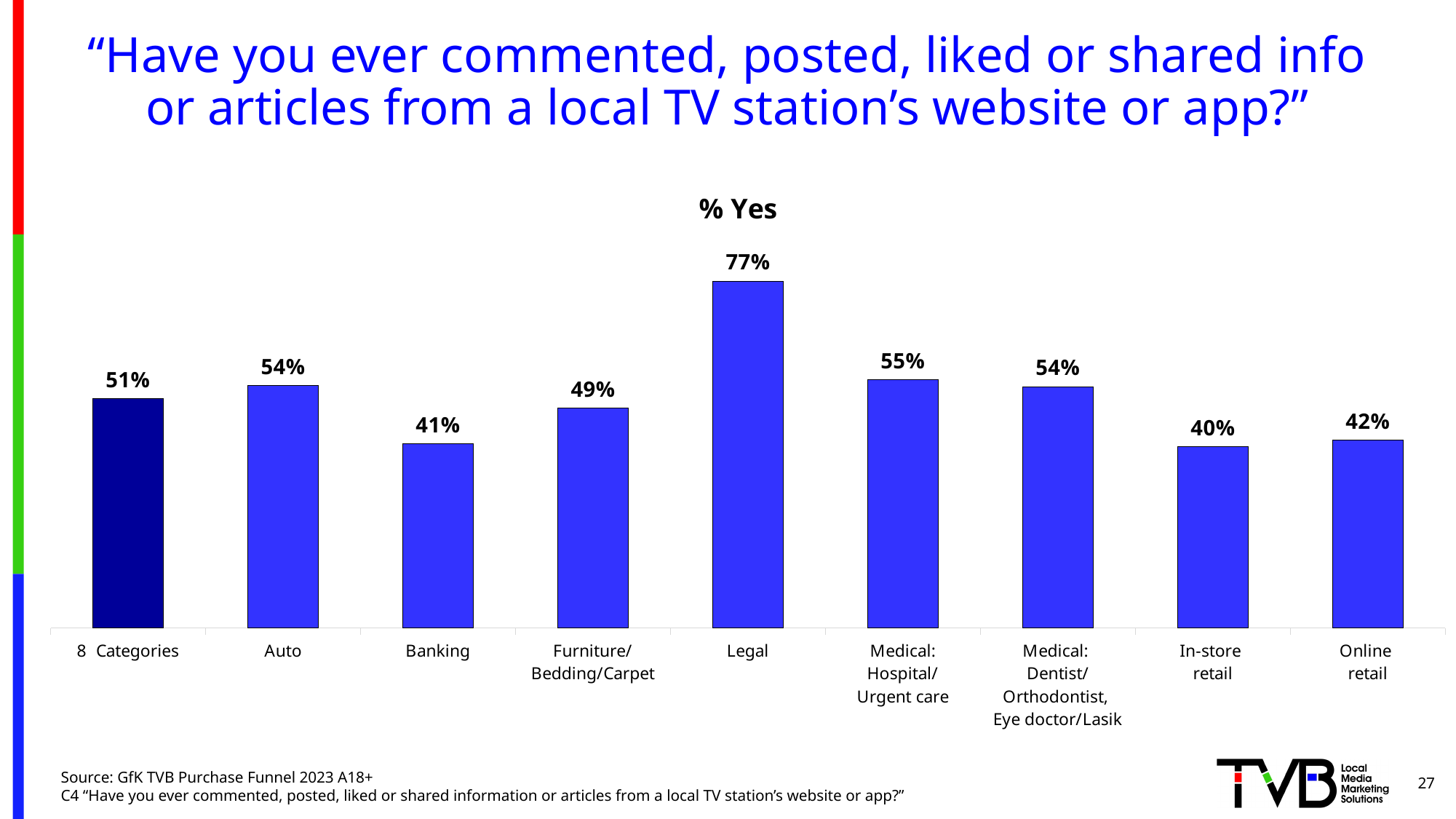
What is the difference in % Yes between Legal and In-store retail? 37% What is the difference in % Yes between Medical: Hospital/Urgent care and Furniture/Bedding/Carpet? 6% Which category has the lowest % Yes? In-store retail Which has a higher % Yes, Auto or Banking? Auto What is the % Yes value for the 8 Categories bar? 51% Which category has the highest % Yes? Legal What is the % Yes value for Online retail? 42% How many bars are shown in the chart? 9 What is the % Yes value for Banking? 41% What is the title of the chart? % Yes What type of chart is shown on the slide? Bar chart What is the % Yes value for Legal? 77%